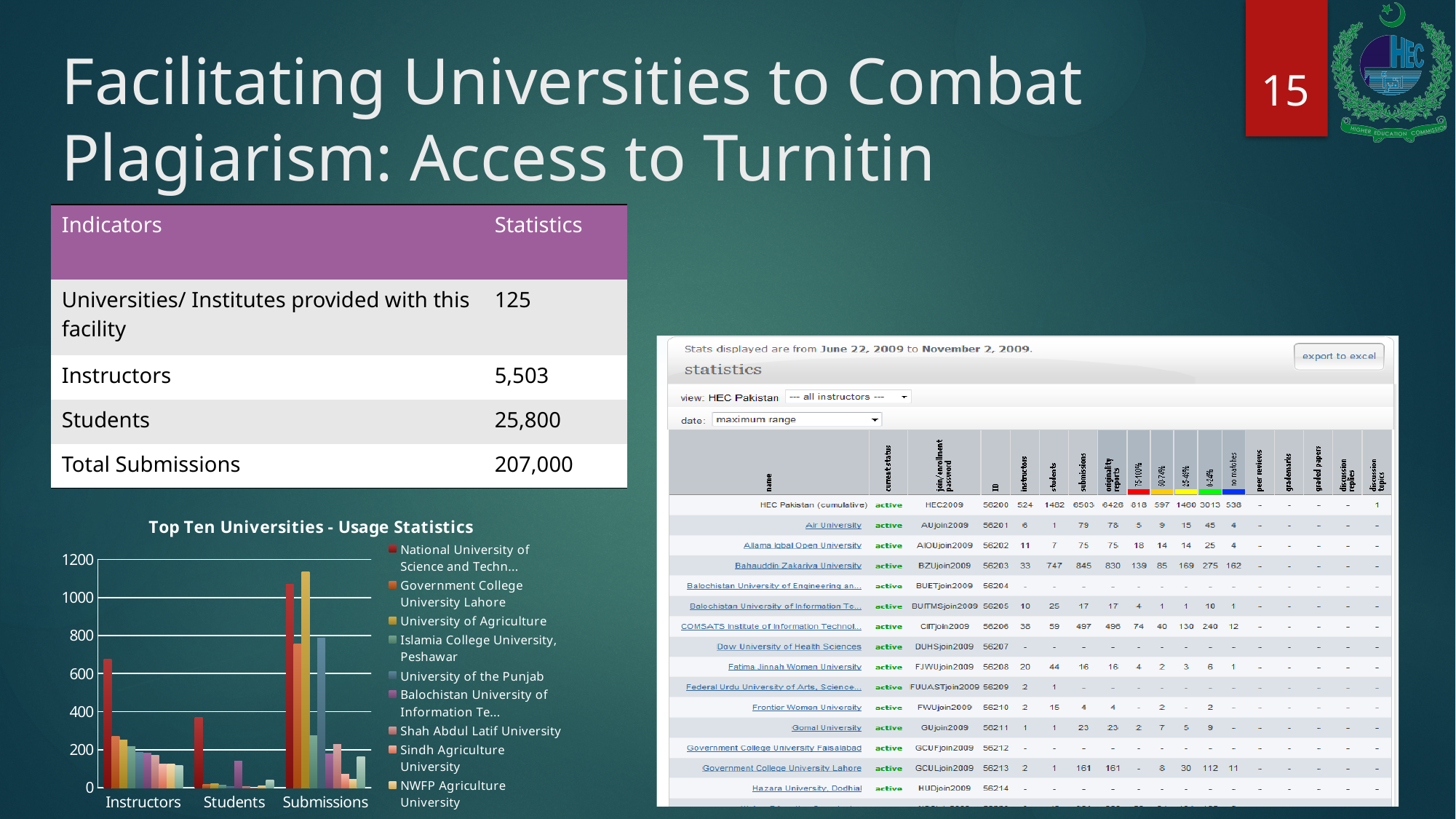
In the 'Top Ten Universities - Usage Statistics' chart, which is larger for Instructors: National University of Science and Techn... or Government College University Lahore? National University of Science and Techn... In the 'Top Ten Universities - Usage Statistics' chart, which university has the highest bar in the Instructors category? National University of Science and Techn... What kind of chart is 'Top Ten Universities - Usage Statistics'? bar chart In the 'Top Ten Universities - Usage Statistics' chart, which is larger for Students: National University of Science and Techn... or Islamia College University, Peshawar? National University of Science and Techn... In the 'Top Ten Universities - Usage Statistics' chart, which university has the highest bar in the Submissions category? University of Agriculture How many categories are shown on the x axis of the 'Top Ten Universities - Usage Statistics' chart? 3 In the 'Top Ten Universities - Usage Statistics' chart, is the Submissions value for Government College University Lahore greater or less than 800? less In the 'Top Ten Universities - Usage Statistics' chart, is the Submissions value for University of Agriculture greater or less than 1000? greater What is the highest value shown on the y axis of the 'Top Ten Universities - Usage Statistics' chart? 1200 In the 'Top Ten Universities - Usage Statistics' chart, is the Instructors value for National University of Science and Techn... greater or less than 600? greater What are the three categories on the x axis of the 'Top Ten Universities - Usage Statistics' chart? Instructors, Students, Submissions